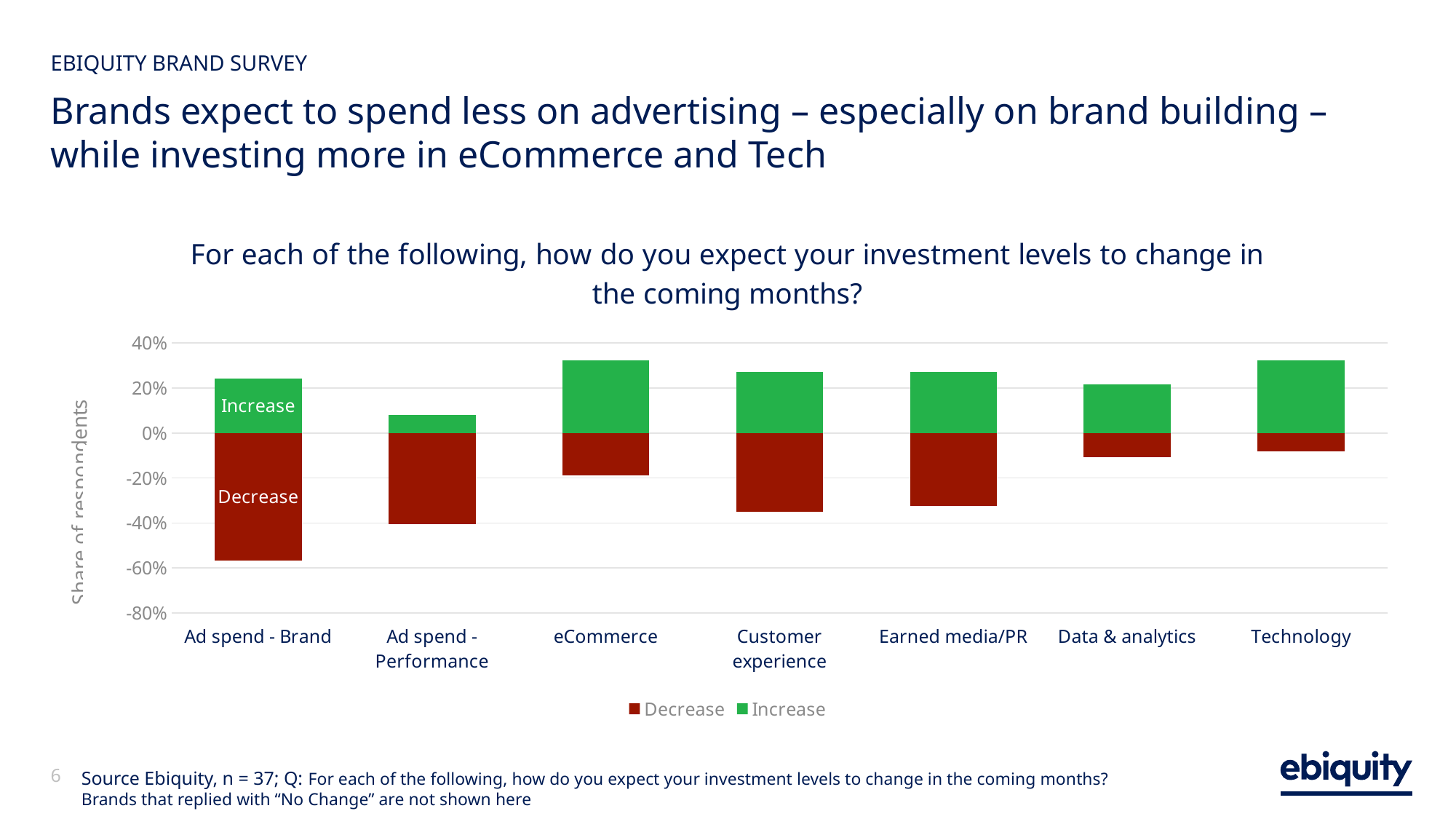
What kind of chart is shown on the slide? bar chart Is the Increase value for Ad spend - Performance greater or less than 20%? less Is the Increase value for Ad spend - Brand larger or smaller than the Increase value for Ad spend - Performance? larger Which category has the smallest Increase share (the shortest green bar)? Ad spend - Performance Is the Decrease value for Data & analytics greater or less than -20%? greater How many categories are shown on the x axis of the chart? 7 Which category has the largest Decrease share (the longest red bar)? Ad spend - Brand Is the Decrease value for Ad spend - Brand greater or less than -40%? less How many series does the chart's legend list? 2 Which colour represents the Decrease series in the chart? red What is the label of the chart's vertical axis? Share of respondents